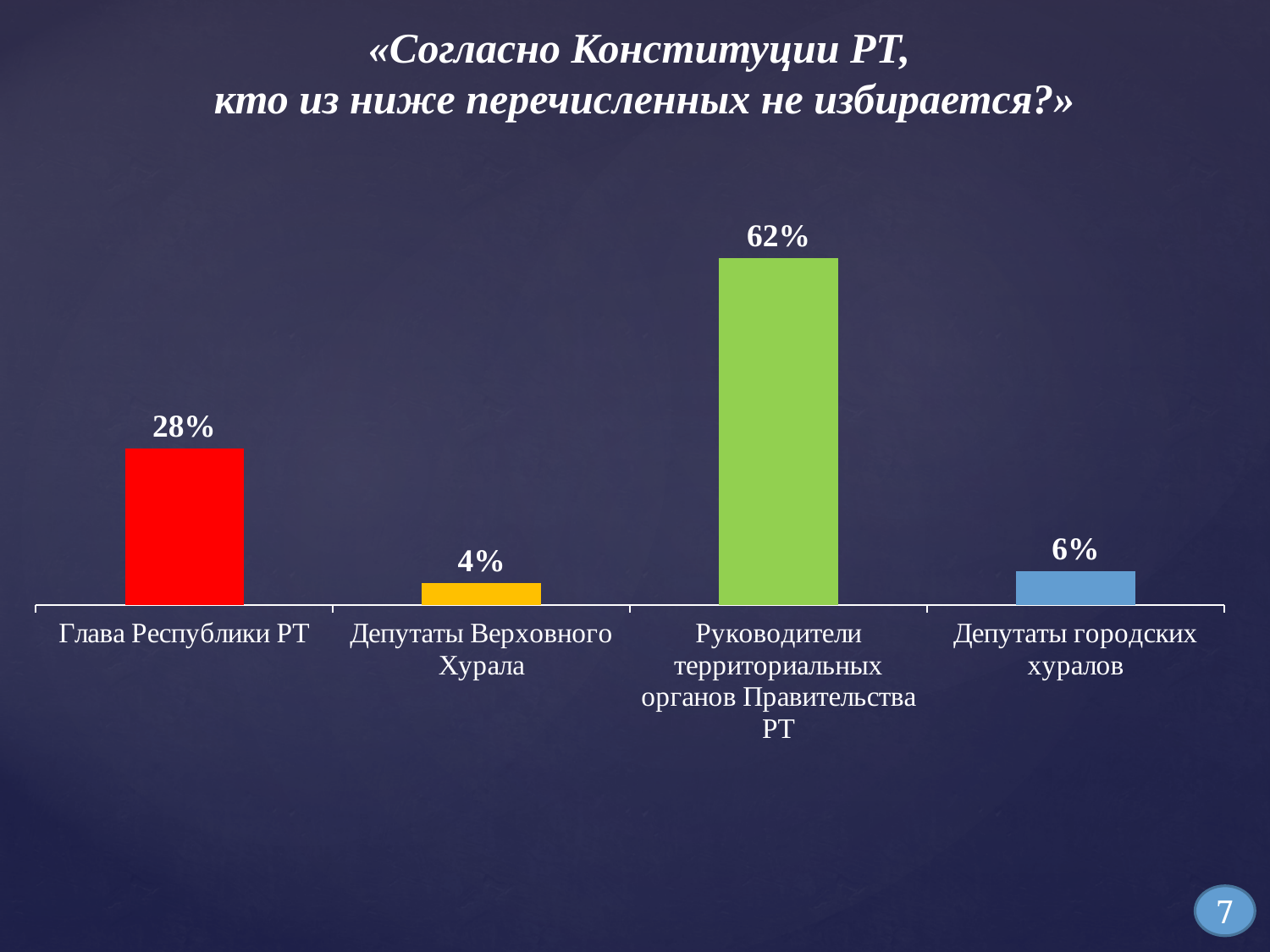
What kind of chart is shown on the slide? Bar chart What is the value for Глава Республики РТ? 28% Which category has the lowest value? Депутаты Верховного Хурала Which is larger, the value for Глава Республики РТ or the value for Депутаты городских хуралов? Глава Республики РТ What is the value for Депутаты Верховного Хурала? 4% Which category has the highest value? Руководители территориальных органов Правительства РТ How many categories are shown in the chart? 4 What is the difference between the values for Руководители территориальных органов Правительства РТ and Глава Республики РТ? 34% What is the difference between the values for Депутаты городских хуралов and Депутаты Верховного Хурала? 2% What is the value for Руководители территориальных органов Правительства РТ? 62% What is the value for Депутаты городских хуралов? 6% What colour is the bar for Руководители территориальных органов Правительства РТ? Green